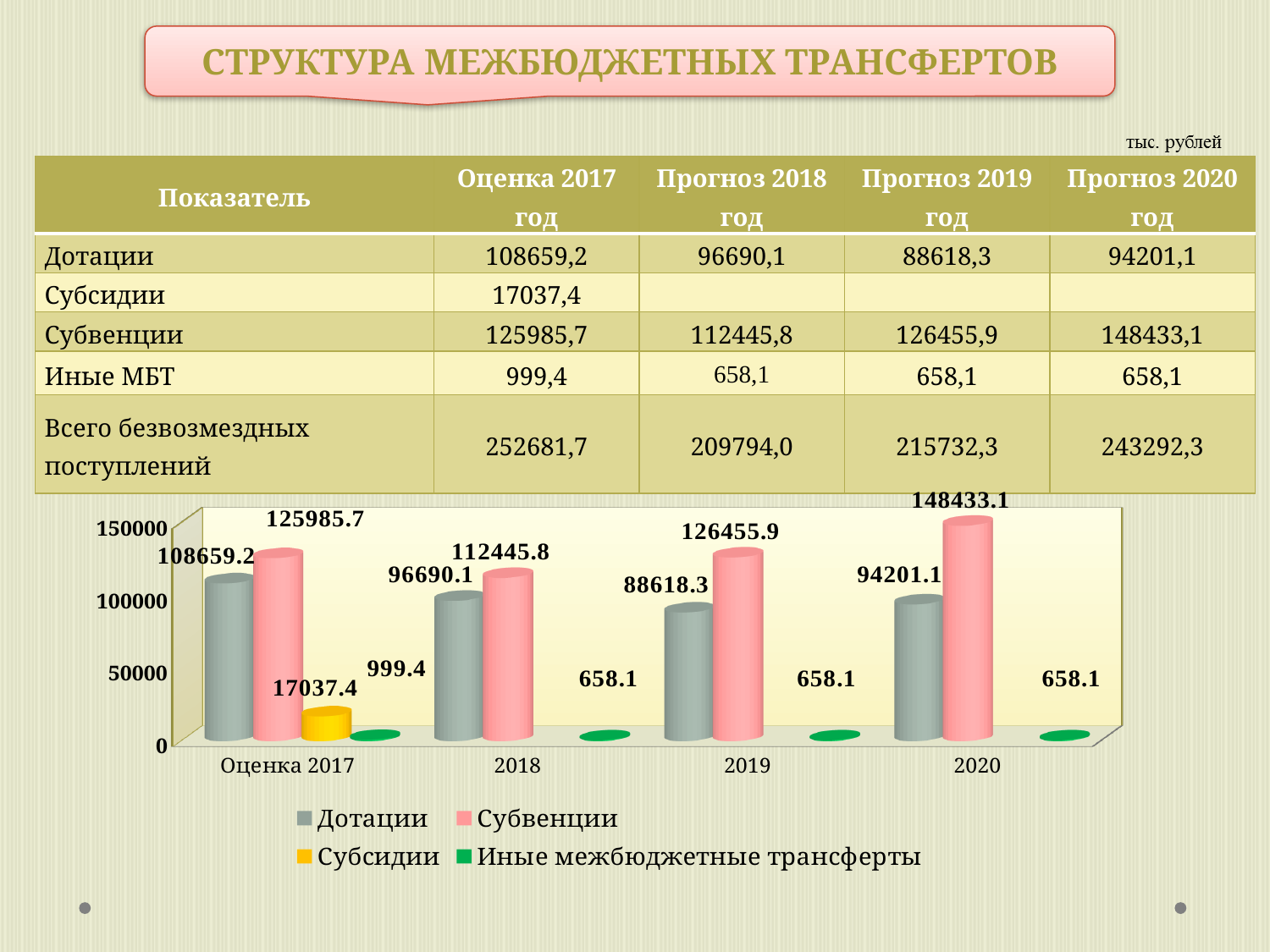
What is the value of Субвенции for 2020 in the chart? 148433.1 How many series does the chart legend list? 4 What is the value of Дотации for Оценка 2017 in the chart? 108659.2 What type of chart is shown on the slide? bar chart In which year is Дотации lowest in the chart? 2019 Which is larger in 2019: Дотации or Субвенции? Субвенции What is the value of Субсидии for Оценка 2017 in the chart? 17037.4 What is the difference between Субвенции and Дотации for 2018 in the chart? 15755.7 How many year categories are shown on the x axis of the chart? 4 Is the value of Дотации for 2020 greater or less than 100000? less In which year does Субвенции reach its highest value in the chart? 2020 What is the value of Иные межбюджетные трансферты for 2019 in the chart? 658.1